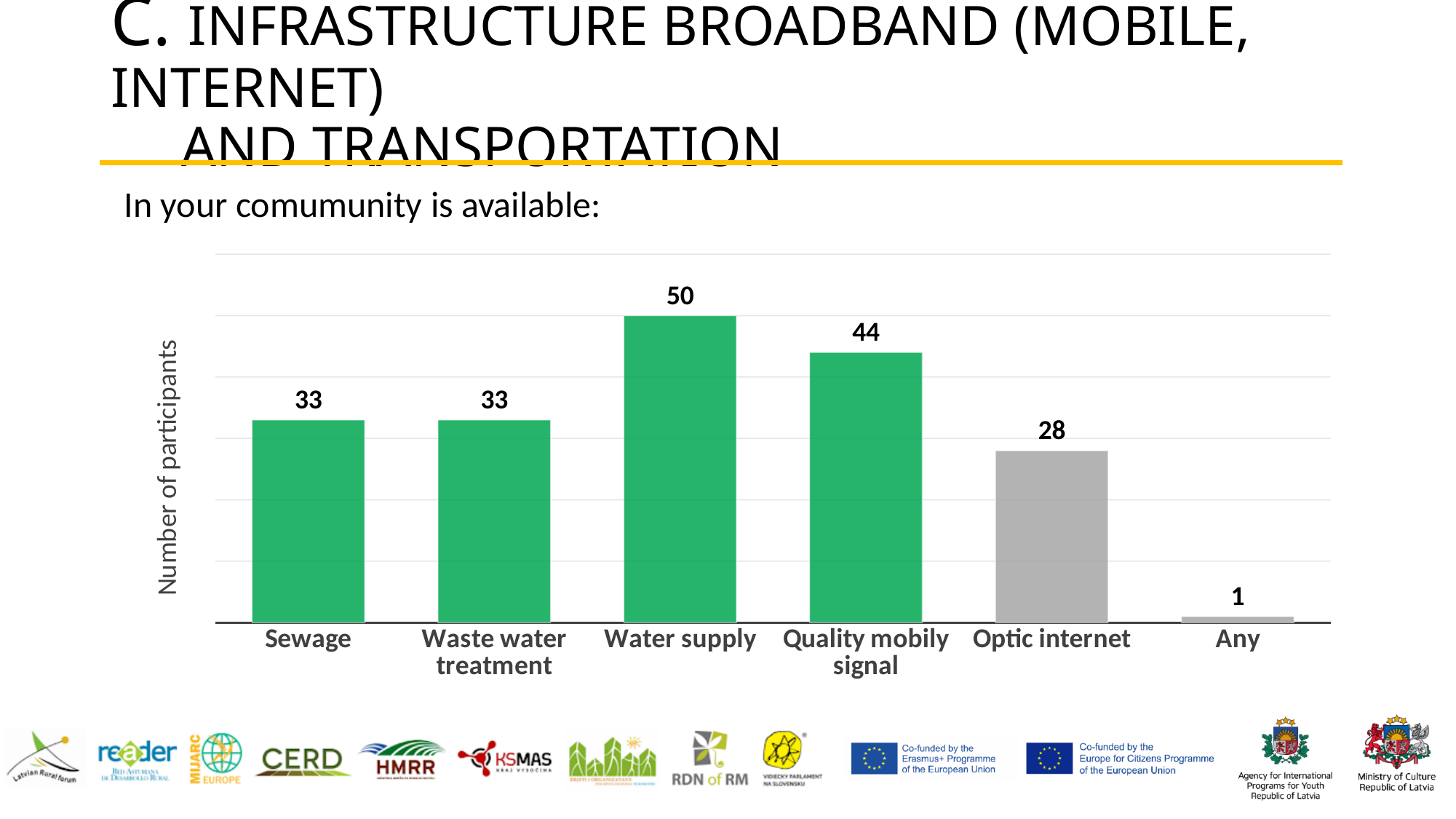
Which is larger, the value for Quality mobily signal or the value for Optic internet? Quality mobily signal What is the difference between the values for Water supply and Quality mobily signal? 6 What is the value for Quality mobily signal? 44 How many categories are shown on the x axis? 6 What kind of chart is shown on the slide? Bar chart Which category has the lowest value? Any What is the label of the vertical axis? Number of participants What is the value for Any? 1 What is the value for Water supply? 50 Which category has the highest value? Water supply What is the value for Optic internet? 28 What is the difference between the values for Sewage and Optic internet? 5